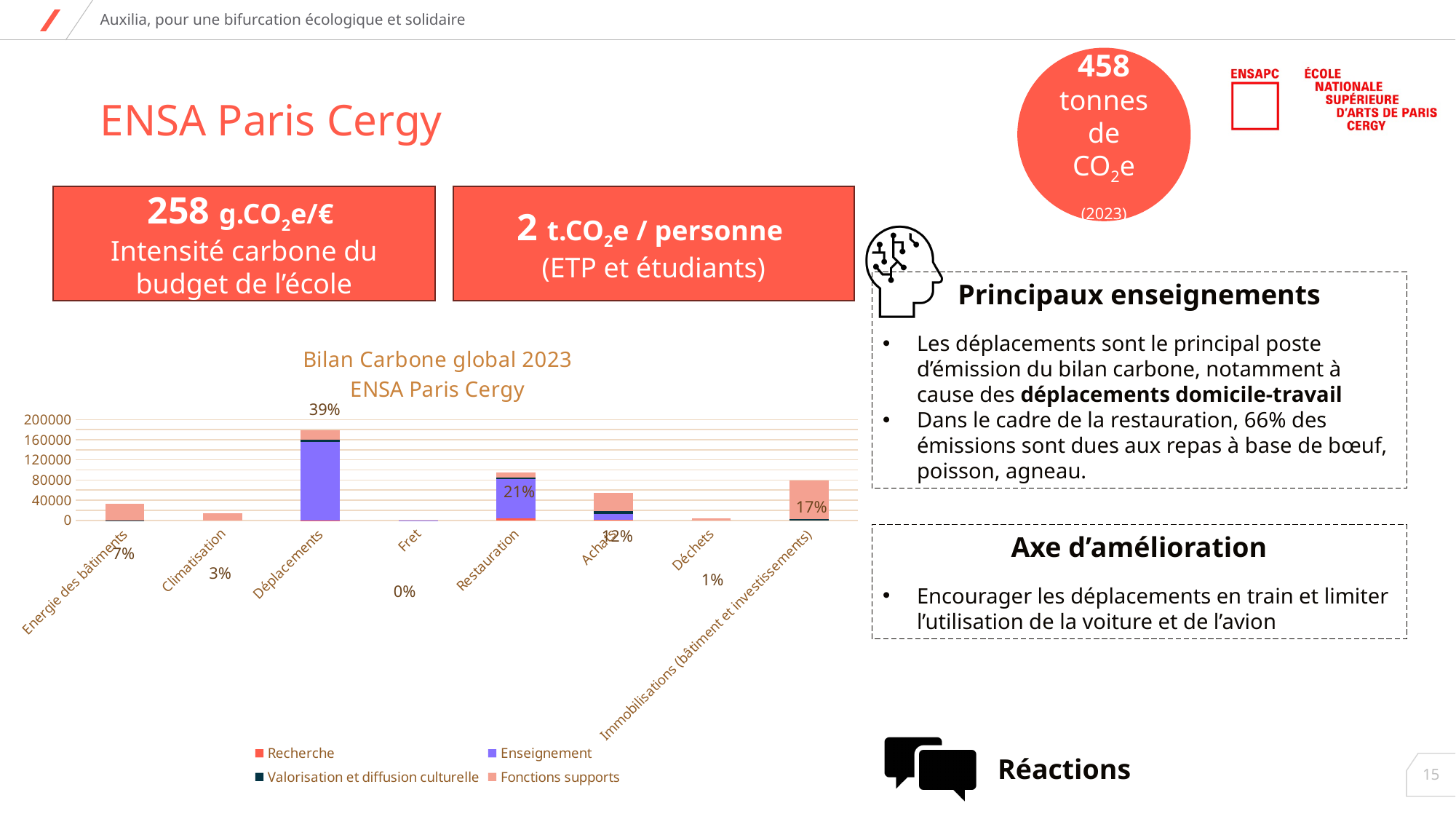
What percentage label is shown for Restauration in the Bilan Carbone chart? 21% What kind of chart is shown under the title 'Bilan Carbone global 2023 ENSA Paris Cergy'? Stacked bar chart Which category has the highest bar in the Bilan Carbone chart? Déplacements How many series does the legend of the Bilan Carbone chart list? 4 Which category has the lowest bar in the Bilan Carbone chart? Fret In the Bilan Carbone chart, is the total value for Déplacements greater or less than 120000? greater In the Bilan Carbone chart, what is the difference in percentage points between the labels for Déplacements and Restauration? 18 percentage points How many categories are shown on the x axis of the Bilan Carbone chart? 8 What percentage label is shown for Déplacements in the Bilan Carbone chart? 39% What percentage label is shown for Immobilisations (bâtiment et investissements) in the Bilan Carbone chart? 17% What percentage label is shown for Fret in the Bilan Carbone chart? 0% In the Bilan Carbone chart, which bar is taller: Achats or Climatisation? Achats